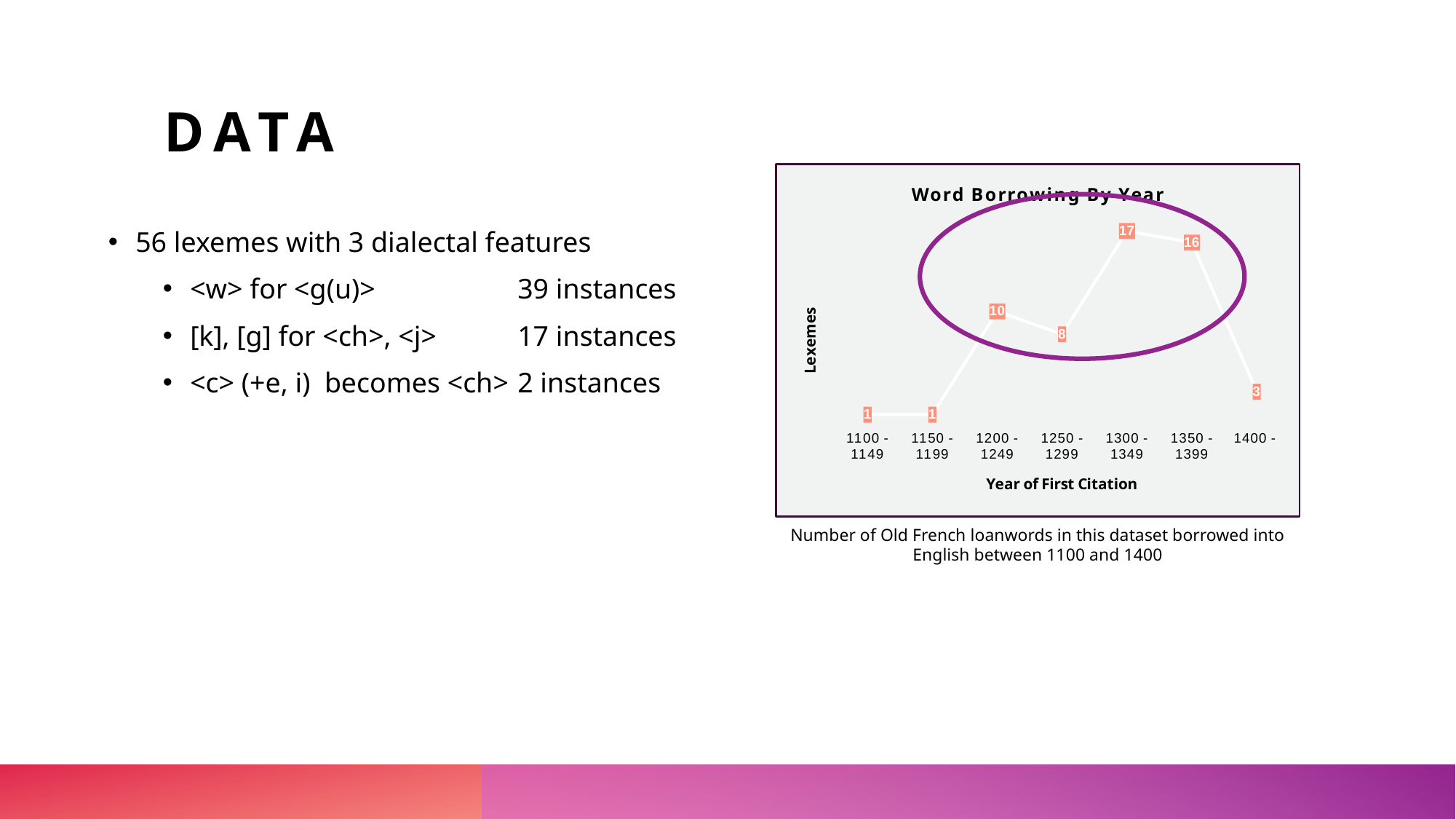
What is the title of the chart? Word Borrowing By Year What is the value for 1400 - ? 3 What is the difference between the values for 1200 - 1249 and 1250 - 1299? 2 How many data points are plotted on the chart? 7 What is the value for 1200 - 1249? 10 What is the label of the x axis? Year of First Citation Which is larger, the value for 1250 - 1299 or the value for 1400 - ? 1250 - 1299 How many lexemes were first cited in 1300 - 1349? 17 What type of chart is shown on the slide? line chart What is the difference between the values for 1300 - 1349 and 1350 - 1399? 1 Which period has the highest number of lexemes? 1300 - 1349 Do the values rise or fall from 1350 - 1399 to 1400 - ? fall